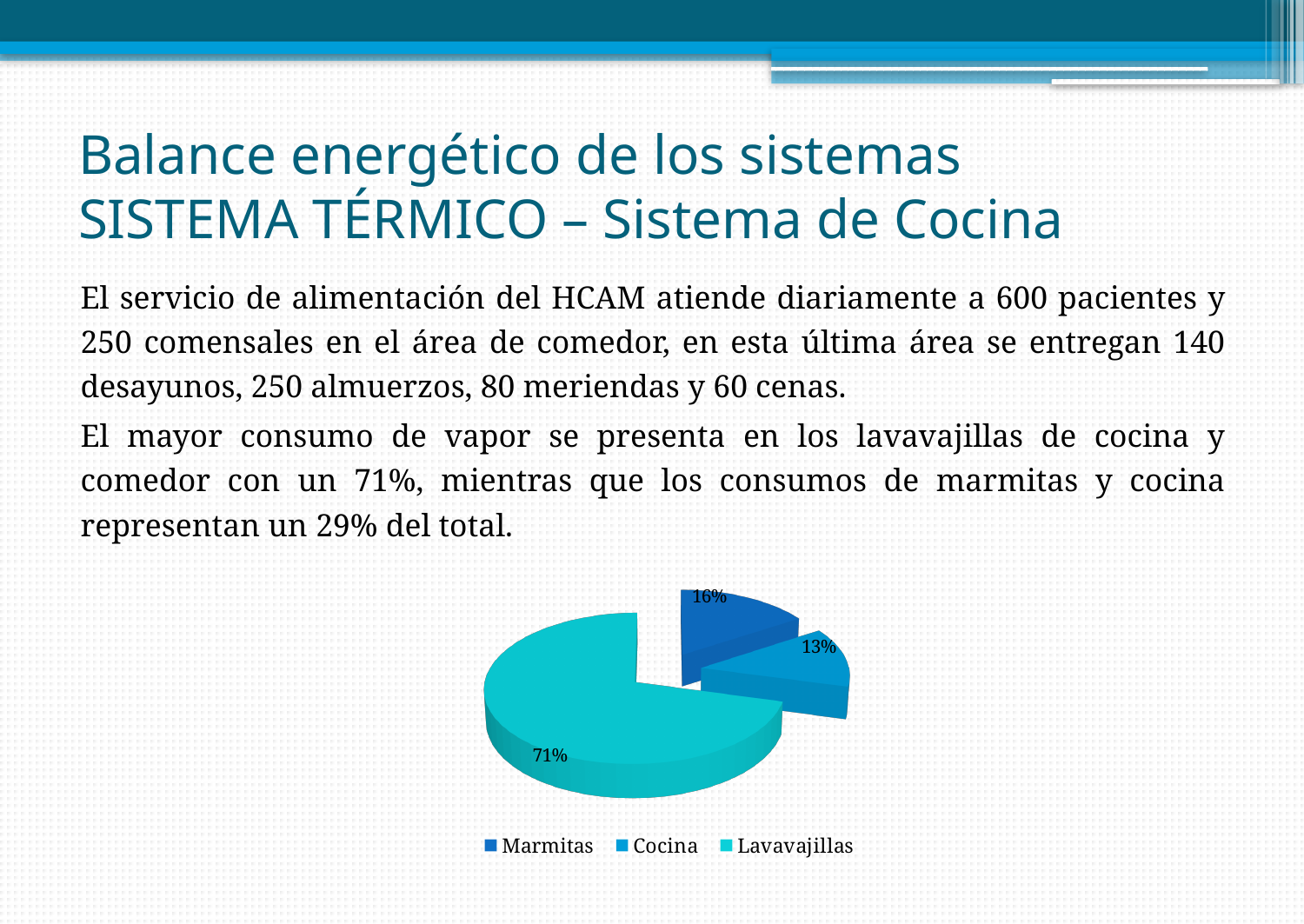
What is the difference in percentage points between the Lavavajillas share and the Marmitas share? 55 Which category has the largest slice of the pie? Lavavajillas What are the three entries listed in the chart legend? Marmitas, Cocina, Lavavajillas What share of the pie does Cocina represent? 13% What kind of chart is shown on the slide? Pie chart Which category has the smallest slice of the pie? Cocina Which is larger, the share for Marmitas or the share for Cocina? Marmitas What is the difference in percentage points between the Marmitas share and the Cocina share? 3 How many categories are shown in the pie chart? 3 What is the combined share of Marmitas and Cocina? 29% What share of the pie does Lavavajillas represent? 71% What share of the pie does Marmitas represent? 16%